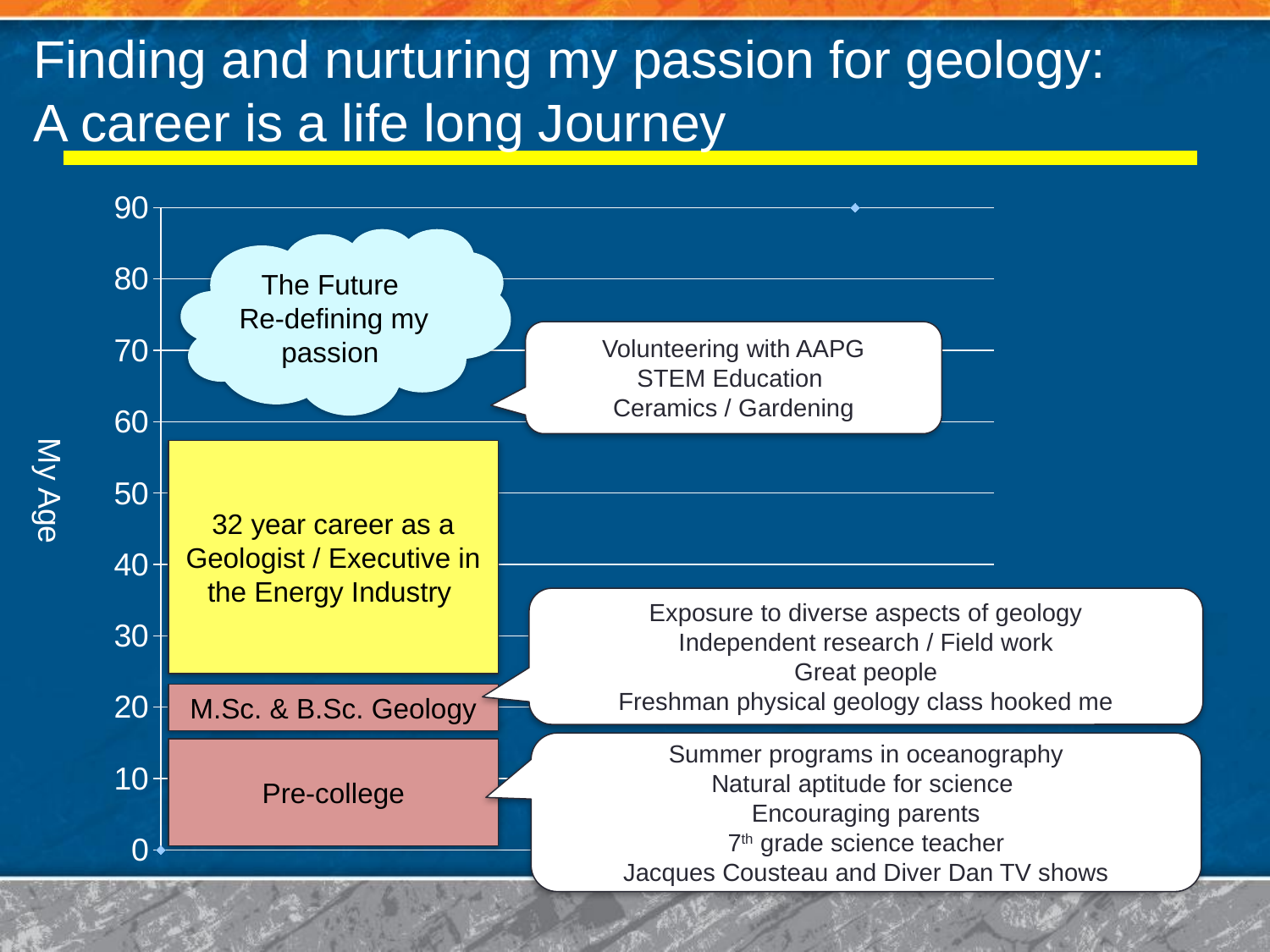
Is the top of the 'Pre-college' box greater or less than age 20? less Is the bottom of 'The Future' cloud greater or less than age 50? greater Which stage spans more years on the age axis: '32 year career as a Geologist / Executive' or 'M.Sc. & B.Sc. Geology'? 32 year career as a Geologist / Executive Which stage spans more years on the age axis: 'Pre-college' or 'M.Sc. & B.Sc. Geology'? Pre-college Which stage sits highest on the age axis? The Future Is the top of the 'M.Sc. & B.Sc. Geology' box greater or less than age 30? less According to its label, how many years did the career as a Geologist / Executive in the Energy Industry last? 32 What is the highest tick value shown on the age axis? 90 How many labelled life stages (boxes and cloud) are placed along the age axis? 4 What is the label on the vertical axis of the chart? My Age Which stage sits lowest on the age axis? Pre-college